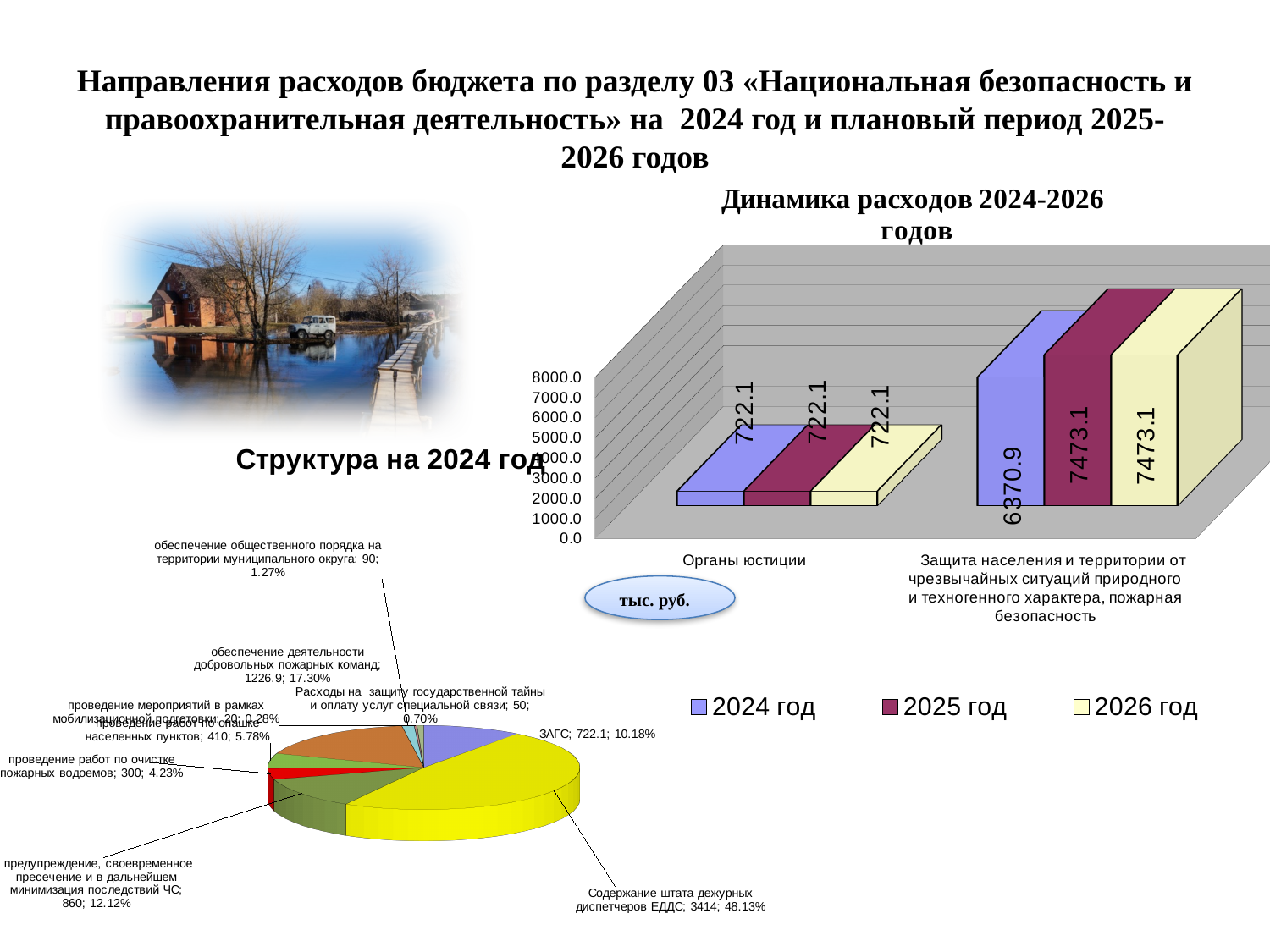
In the pie chart "Структура на 2024 год", which slice is the smallest? проведение мероприятий в рамках мобилизационной подготовки In the chart "Динамика расходов 2024-2026 годов", what is the value for "Защита населения и территории от чрезвычайных ситуаций природного и техногенного характера, пожарная безопасность" in 2024 год? 6370.9 What kind of chart is "Динамика расходов 2024-2026 годов"? bar chart In the pie chart "Структура на 2024 год", how many slices are there? 9 In the chart "Динамика расходов 2024-2026 годов", what is the difference between the 2025 год and 2024 год values for "Защита населения и территории от чрезвычайных ситуаций..."? 1102.2 In the chart "Динамика расходов 2024-2026 годов", what unit is shown in the callout next to the chart? тыс. руб. In the chart "Динамика расходов 2024-2026 годов", what is the value for "Органы юстиции" in 2025 год? 722.1 In the pie chart "Структура на 2024 год", what is the value for "Содержание штата дежурных диспетчеров ЕДДС"? 3414 In the chart "Динамика расходов 2024-2026 годов", what is the value for "Защита населения и территории от чрезвычайных ситуаций..." in 2026 год? 7473.1 In the pie chart "Структура на 2024 год", what share does "обеспечение деятельности добровольных пожарных команд" have? 17.30% In the chart "Динамика расходов 2024-2026 годов", how many series does the legend list? 3 In the chart "Динамика расходов 2024-2026 годов", which category has the higher values, "Органы юстиции" or "Защита населения и территории от чрезвычайных ситуаций..."? Защита населения и территории от чрезвычайных ситуаций природного и техногенного характера, пожарная безопасность